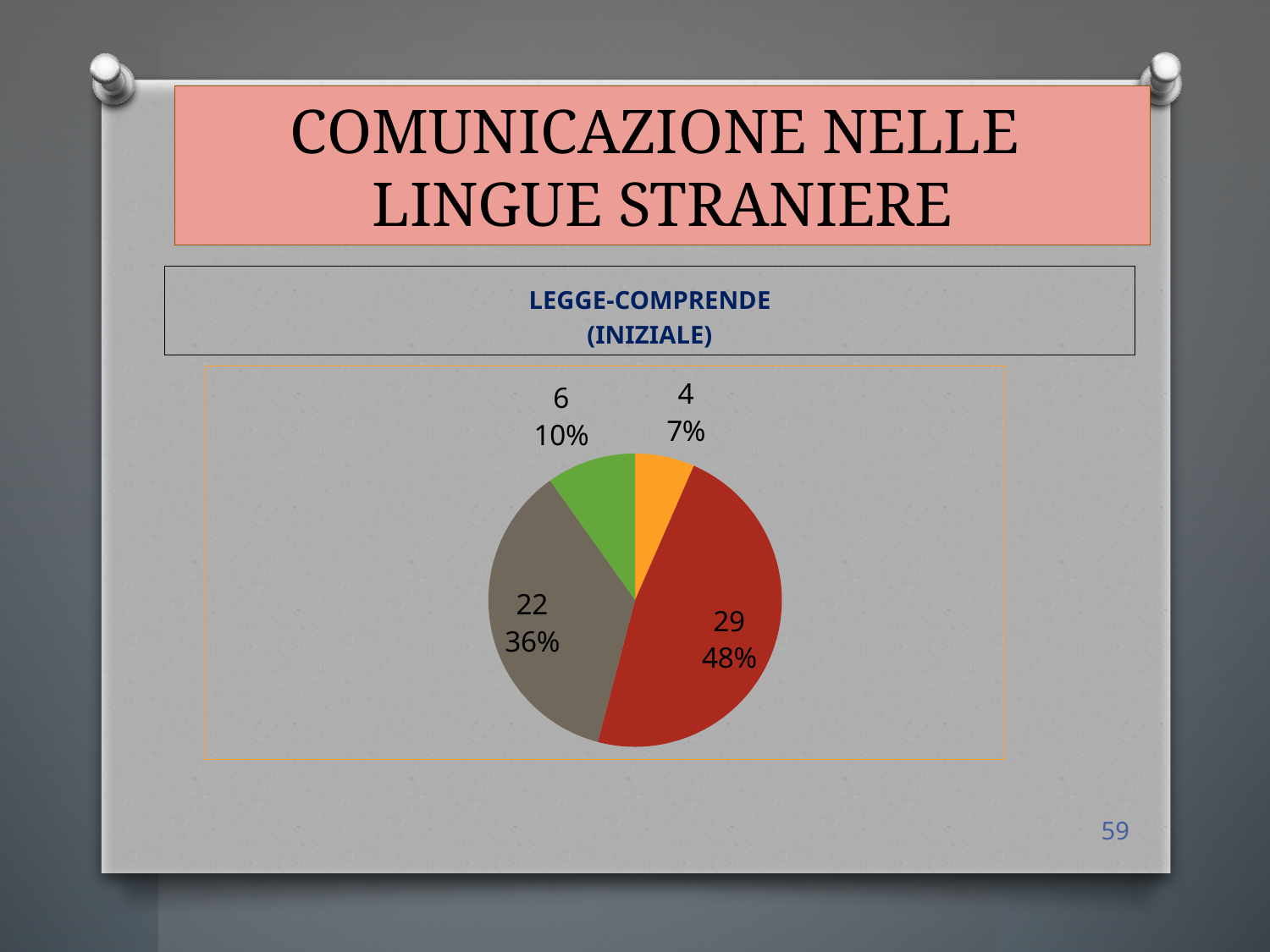
What is the title of the chart? LEGGE-COMPRENDE (INIZIALE) Which slice of the pie chart has the largest share? the red slice (48%) How many slices does the pie chart have? 4 Which slice of the pie chart has the smallest share? the orange slice (7%) What value is shown on the red slice of the pie chart? 29 What value is shown on the green slice of the pie chart? 6 Which is larger, the value of the green slice or the value of the orange slice? the green slice What percentage is shown on the grey slice of the pie chart? 36% What percentage is shown on the orange slice of the pie chart? 7% What is the sum of the four values shown on the pie chart? 61 What kind of chart is shown on the slide? pie chart What is the difference between the value of the red slice and the value of the grey slice? 7